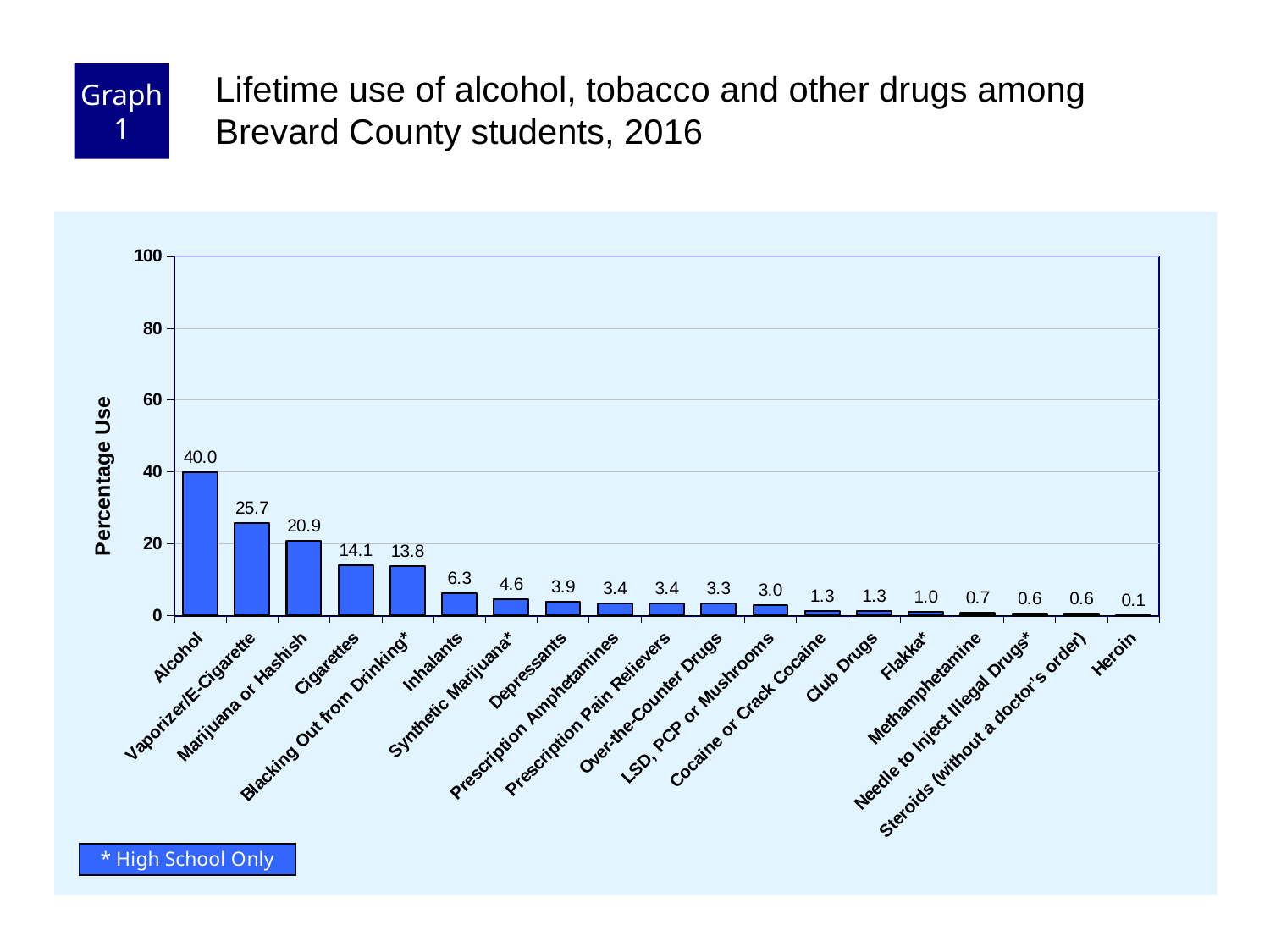
What is the difference in percentage use between Alcohol and Cigarettes? 25.9 What is the label of the y axis? Percentage Use How many categories are shown on the x axis? 19 What is the percentage use for Inhalants? 6.3 What is the percentage use for Alcohol? 40.0 Which category has the highest percentage use? Alcohol Which category has the lowest percentage use? Heroin What kind of chart is shown on the slide? Bar chart What is the percentage use for Vaporizer/E-Cigarette? 25.7 What is the difference in percentage use between Marijuana or Hashish and Blacking Out from Drinking*? 7.1 Is the value for Vaporizer/E-Cigarette greater or less than 20? greater Which has a higher percentage use, Cigarettes or Inhalants? Cigarettes